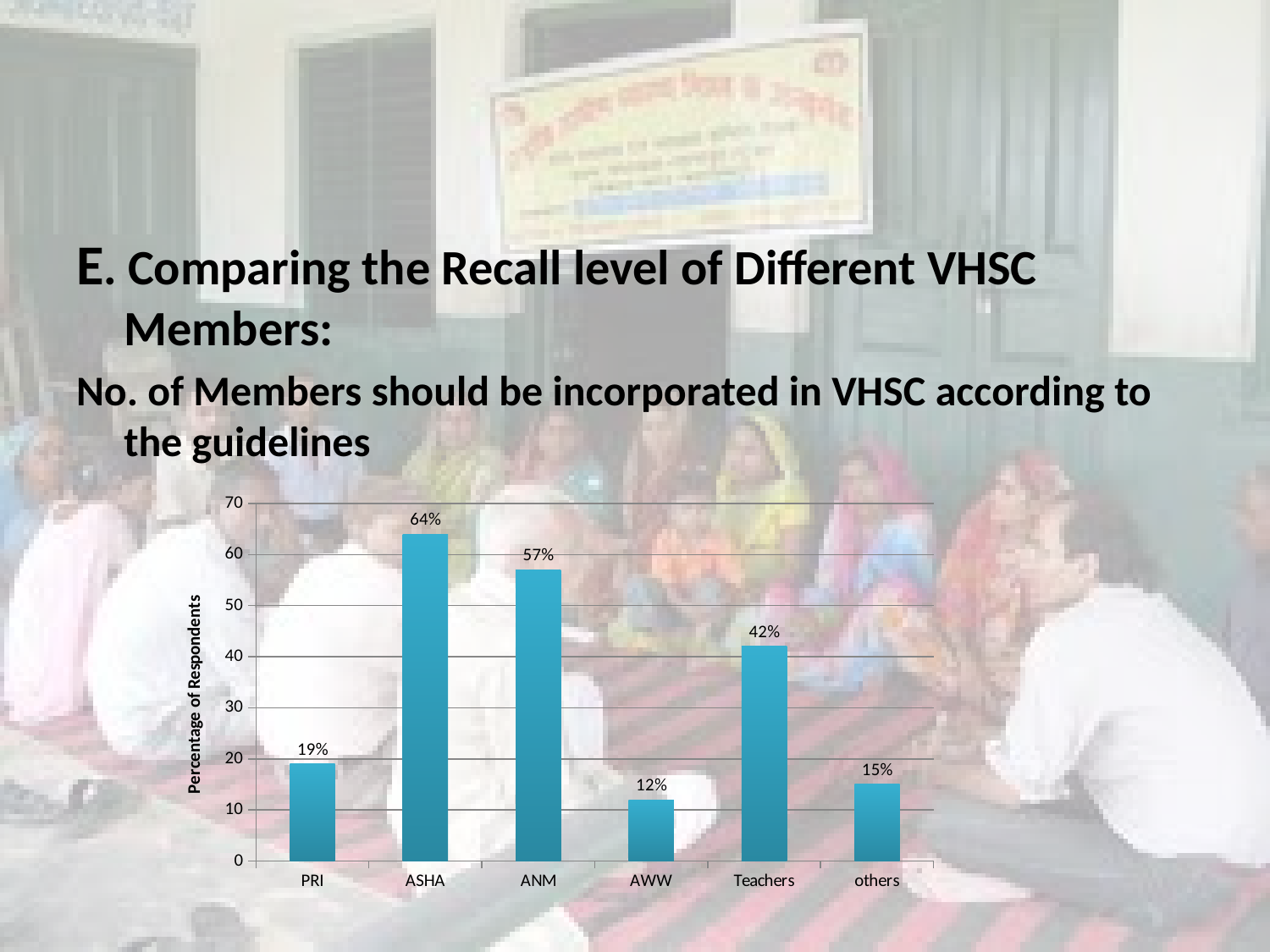
What is the difference between the values for ASHA and ANM? 7% How many categories are shown on the x axis? 6 Which category has the lowest value? AWW Is the value for ANM greater or less than 50? greater Which category has the highest value? ASHA What is the value for Teachers? 42% What is the label of the vertical axis? Percentage of Respondents What is the value for PRI? 19% What kind of chart is shown on the slide? bar chart What is the difference between the values for Teachers and AWW? 30% Which is larger, the value for PRI or the value for others? PRI What is the value for ASHA? 64%